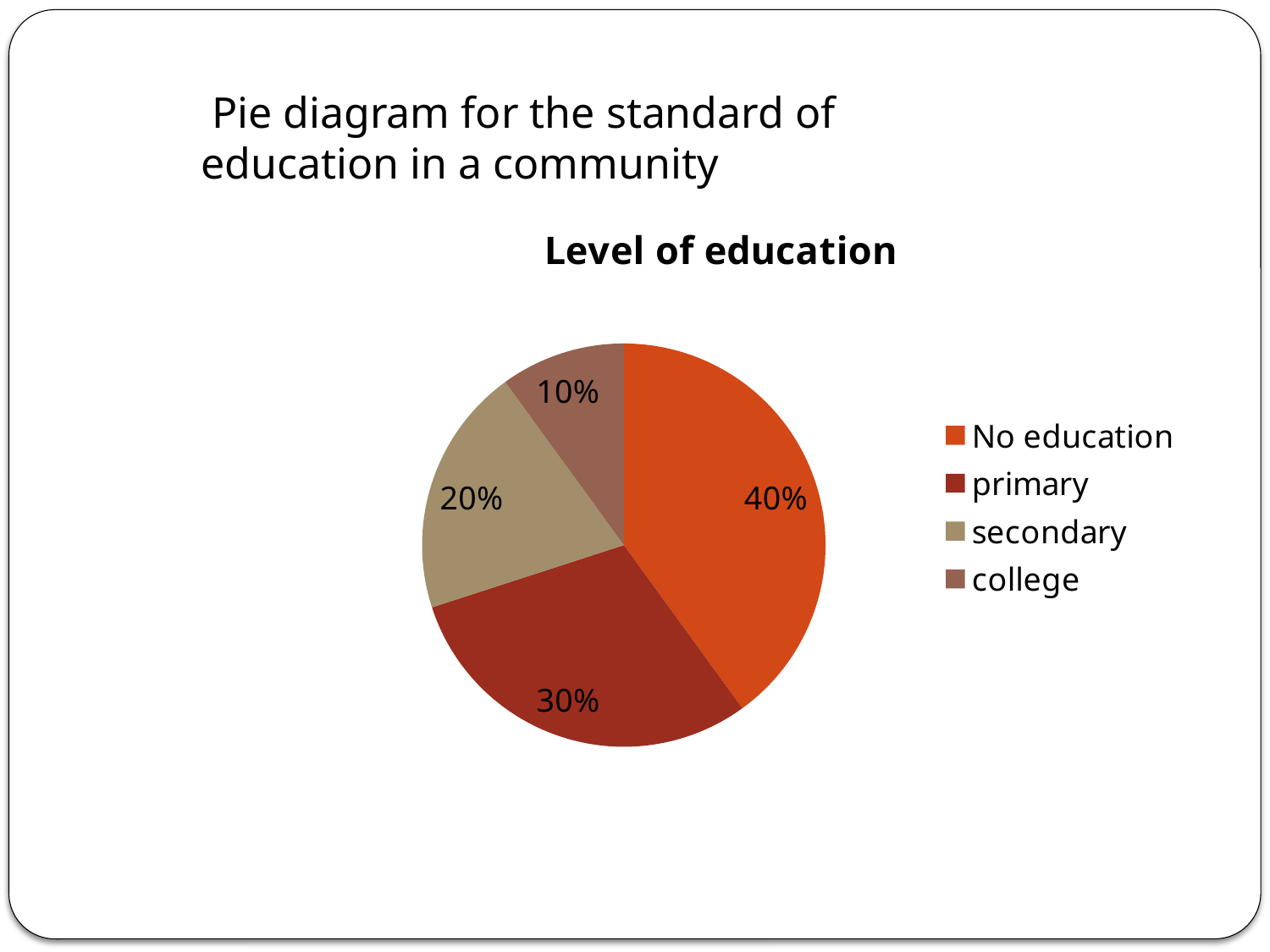
What kind of chart is shown on the slide? pie chart What is the difference between the No education and college slices? 30% How many entries does the legend list? 4 What is the title of the chart? Level of education What share of the pie does the No education slice represent? 40% Which is larger, the primary slice or the secondary slice? primary What is the value shown for the secondary slice? 20% Which category has the smallest slice of the pie? college Which category has the largest slice of the pie? No education What is the value shown for the college slice? 10% What is the value shown for the primary slice? 30% How many categories does the pie chart have? 4